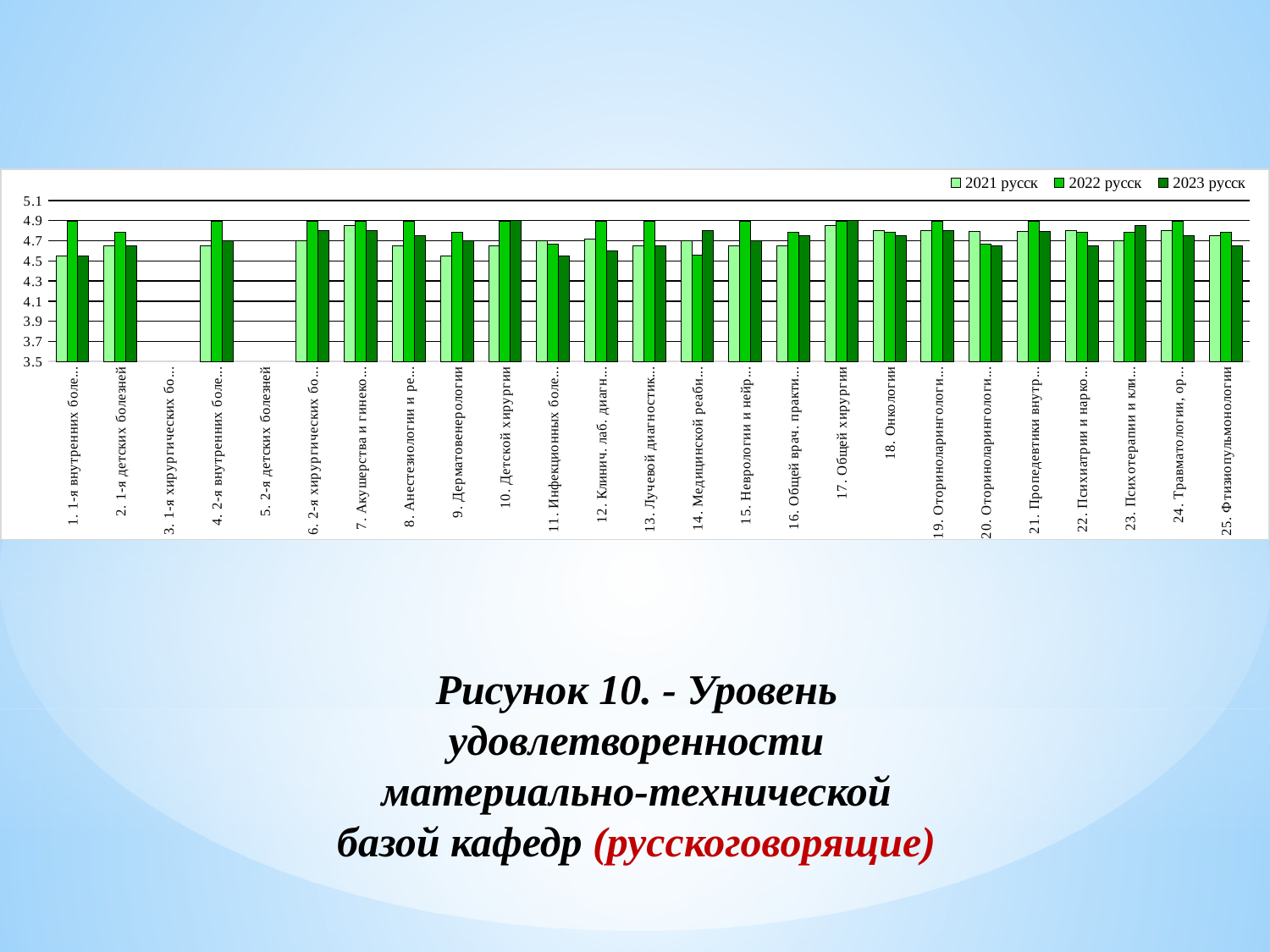
How many series does the chart legend list? 3 Is the 2023 русск value for "17. Общей хирургии" greater or less than 4.7? greater How many categories are labelled along the x axis of the chart? 25 How many labelled categories on the x axis have no bars plotted at all? 2 Is the 2021 русск value for "9. Дерматовенерологии" greater or less than 4.7? less Is the 2022 русск value for "10. Детской хирургии" greater or less than 4.7? greater What kind of chart is shown on the slide? bar chart For "14. Медицинской реаби...", which series has the larger value, 2022 русск or 2023 русск? 2023 русск For "1. 1-я внутренних боле...", which series has the larger value, 2021 русск or 2022 русск? 2022 русск What are the three series named in the chart legend? 2021 русск, 2022 русск, 2023 русск